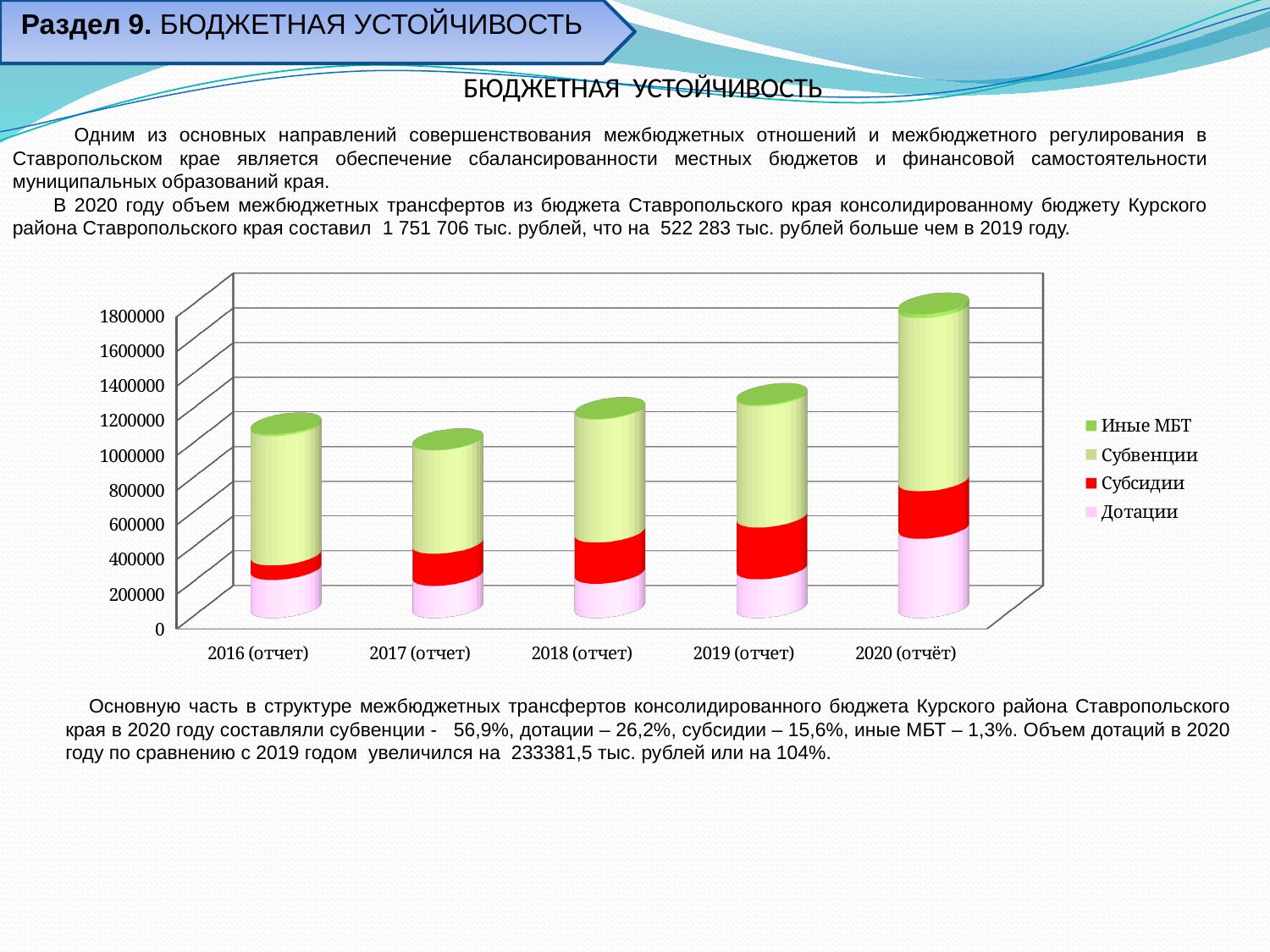
Which stacked bar is taller, 2018 (отчет) or 2017 (отчет)? 2018 (отчет) Which stacked bar is taller, 2020 (отчёт) or 2019 (отчет)? 2020 (отчёт) How many years (categories) are shown on the x axis of the chart? 5 Which year has the shortest stacked bar in the chart? 2017 (отчет) Is the total of the stacked bar for 2017 (отчет) greater or less than 1200000? less Is the total of the stacked bar for 2020 (отчёт) greater or less than 1600000? greater Is the total of the stacked bar for 2019 (отчет) greater or less than 1000000? greater How many series does the chart legend list? 4 Do the stacked bar totals rise or fall from 2017 (отчет) to 2020 (отчёт)? rise Which year has the tallest stacked bar in the chart? 2020 (отчёт) What kind of chart is shown on the slide? stacked bar chart Which series is shown at the bottom of each stacked bar in the chart? Дотации